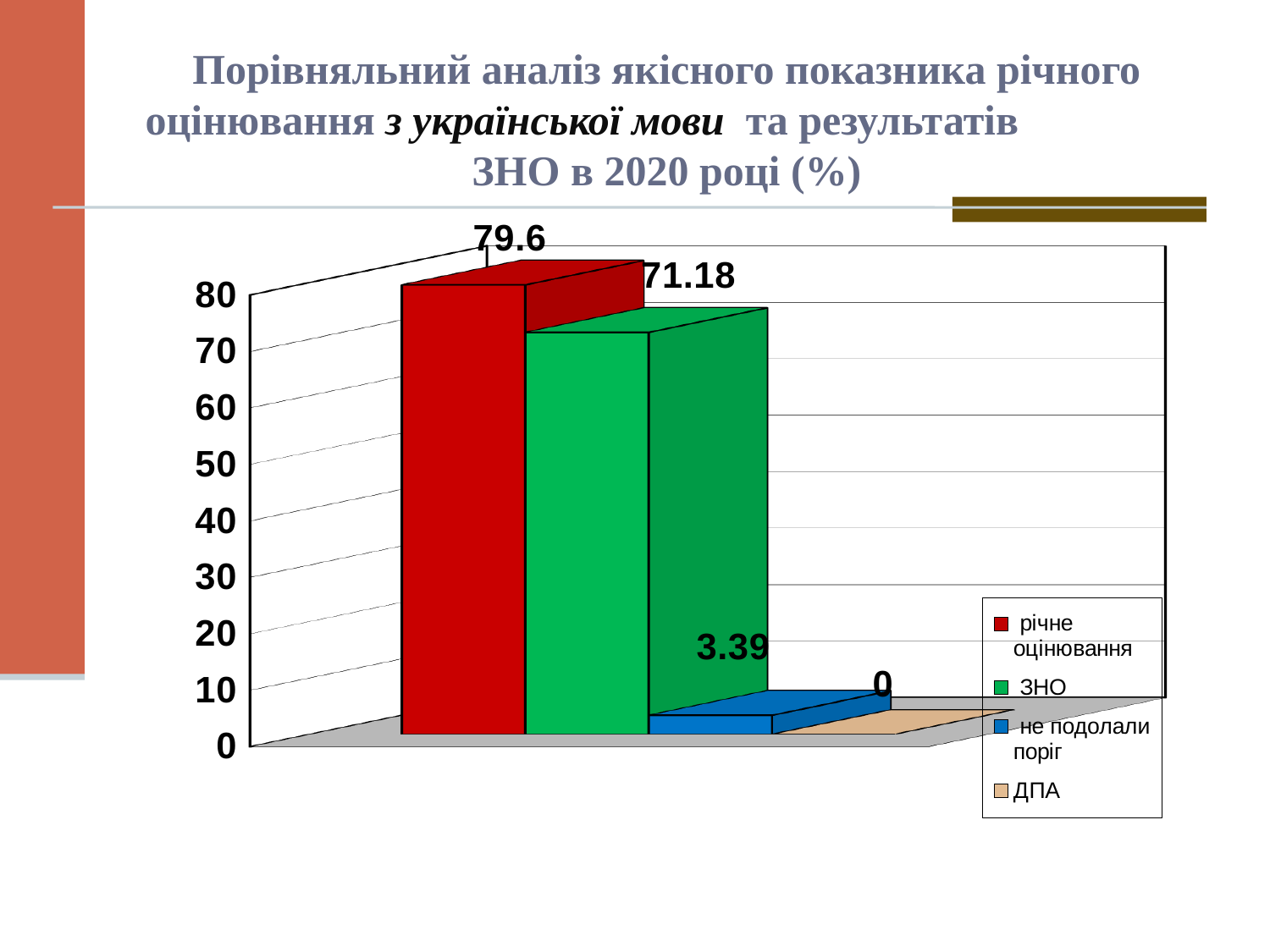
What is the value for не подолали поріг? 3.39 Which series has the lowest value? ДПА What kind of chart is shown on the slide? bar chart What is the value for ДПА? 0 What colour is the bar for ЗНО? green What is the value for річне оцінювання? 79.6 What is the difference between the values for річне оцінювання and ЗНО? 8.42 Is the value for ЗНО greater or less than 70? greater What is the value for ЗНО? 71.18 Which is larger, the value for ЗНО or the value for не подолали поріг? ЗНО Which series has the highest value? річне оцінювання How many series does the legend list? 4